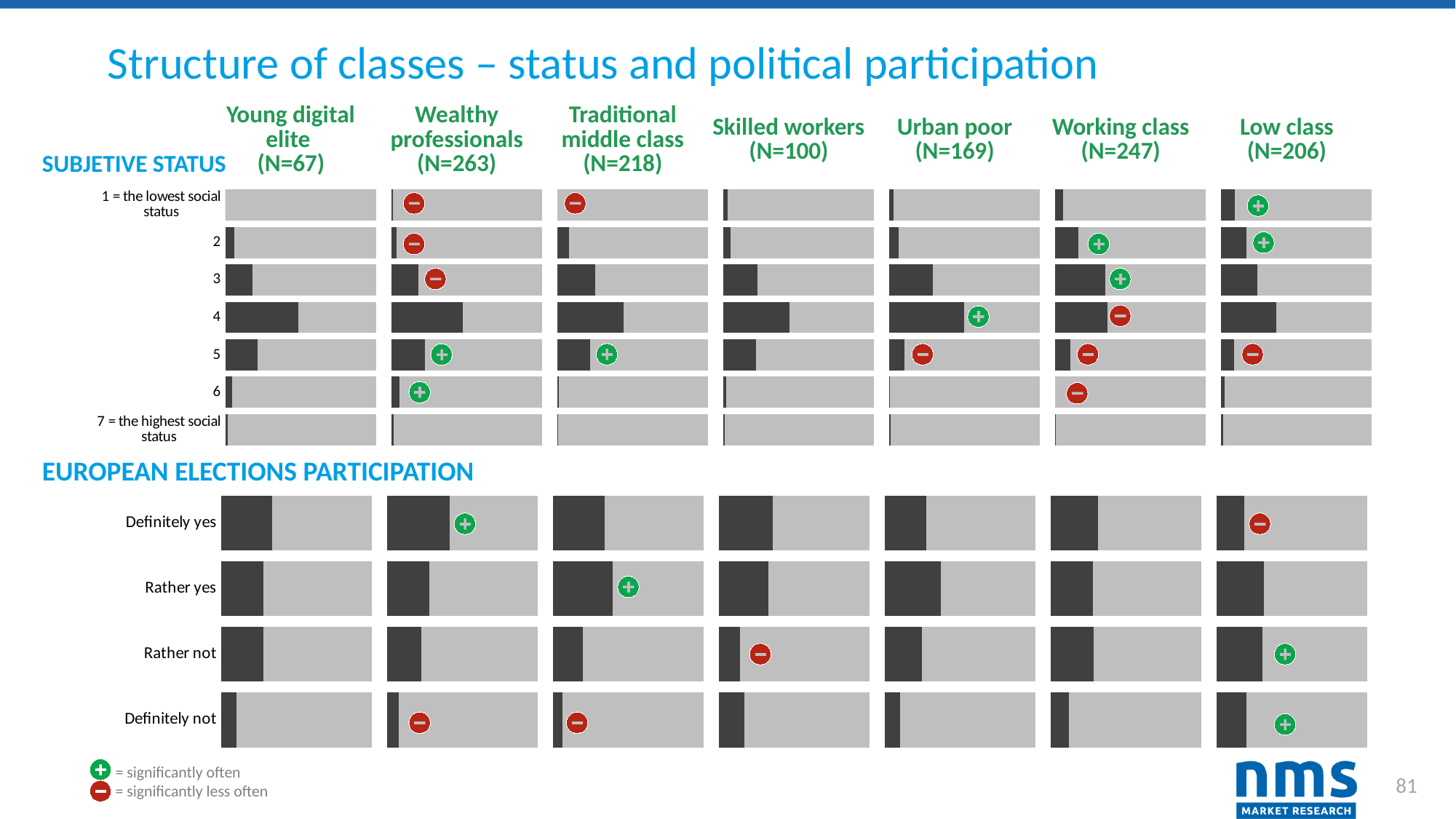
In the EUROPEAN ELECTIONS PARTICIPATION chart, for Wealthy professionals, is the bar for Definitely yes or Definitely not longer? Definitely yes According to the legend, what does the green plus symbol indicate? significantly often In the SUBJECTIVE STATUS chart, which status level has the longest bar for the Urban poor? 4 How many response categories are shown in the EUROPEAN ELECTIONS PARTICIPATION chart? 4 In the EUROPEAN ELECTIONS PARTICIPATION chart, which response has the shortest bar for the Traditional middle class? Definitely not How many class groups are compared across the slide? 7 In the SUBJECTIVE STATUS chart, which status level has the longest bar for the Young digital elite? 4 What kind of chart is used to show the subjective status distribution for each class? bar chart In the SUBJECTIVE STATUS chart, for the Low class, is the bar for status level 2 or status level 5 longer? status level 2 How many subjective status levels are shown as categories in the SUBJECTIVE STATUS chart? 7 In the EUROPEAN ELECTIONS PARTICIPATION chart, which response has the shortest bar for Wealthy professionals? Definitely not What is the sample size (N) shown for Wealthy professionals? N=263